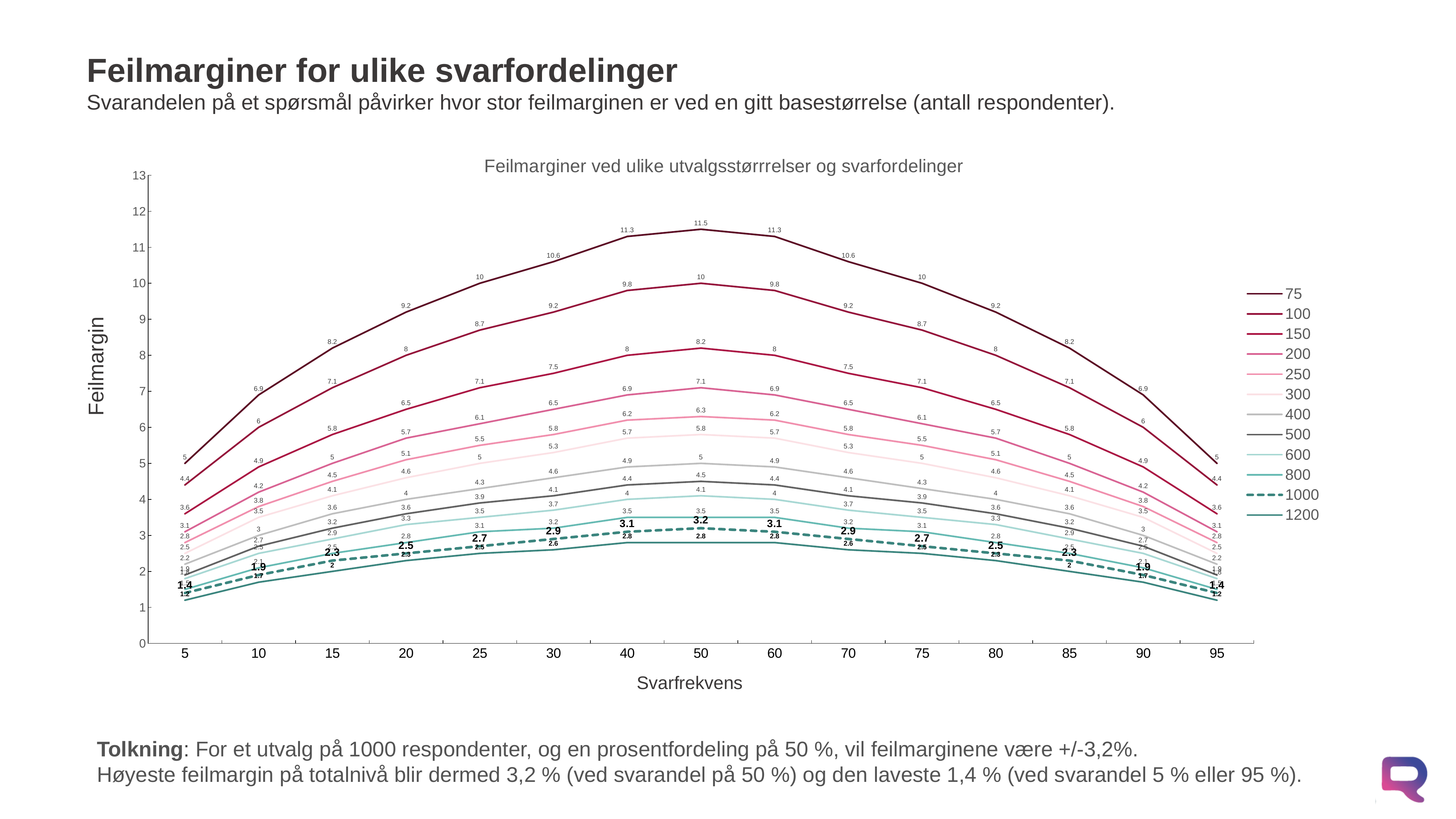
What is the feilmargin for the 1000 series at a svarfrekvens of 50? 3.2 Which series is drawn with a dashed line? 1000 What is the feilmargin for the 100 series at a svarfrekvens of 5? 4.4 What kind of chart is shown on the slide? line chart Does the feilmargin for the 75 series rise or fall as svarfrekvens goes from 5 to 50? rise What is the difference between the 75 series and the 100 series at a svarfrekvens of 50? 1.5 Which series has the lowest feilmargin at a svarfrekvens of 5? 1200 Which series has the highest feilmargin at a svarfrekvens of 50? 75 What is the feilmargin for the 75 series at a svarfrekvens of 50? 11.5 Which is larger: the 75 series at svarfrekvens 40 or the 100 series at svarfrekvens 50? the 75 series at svarfrekvens 40 How many Svarfrekvens values are plotted along the x axis? 15 How many series does the legend list? 12